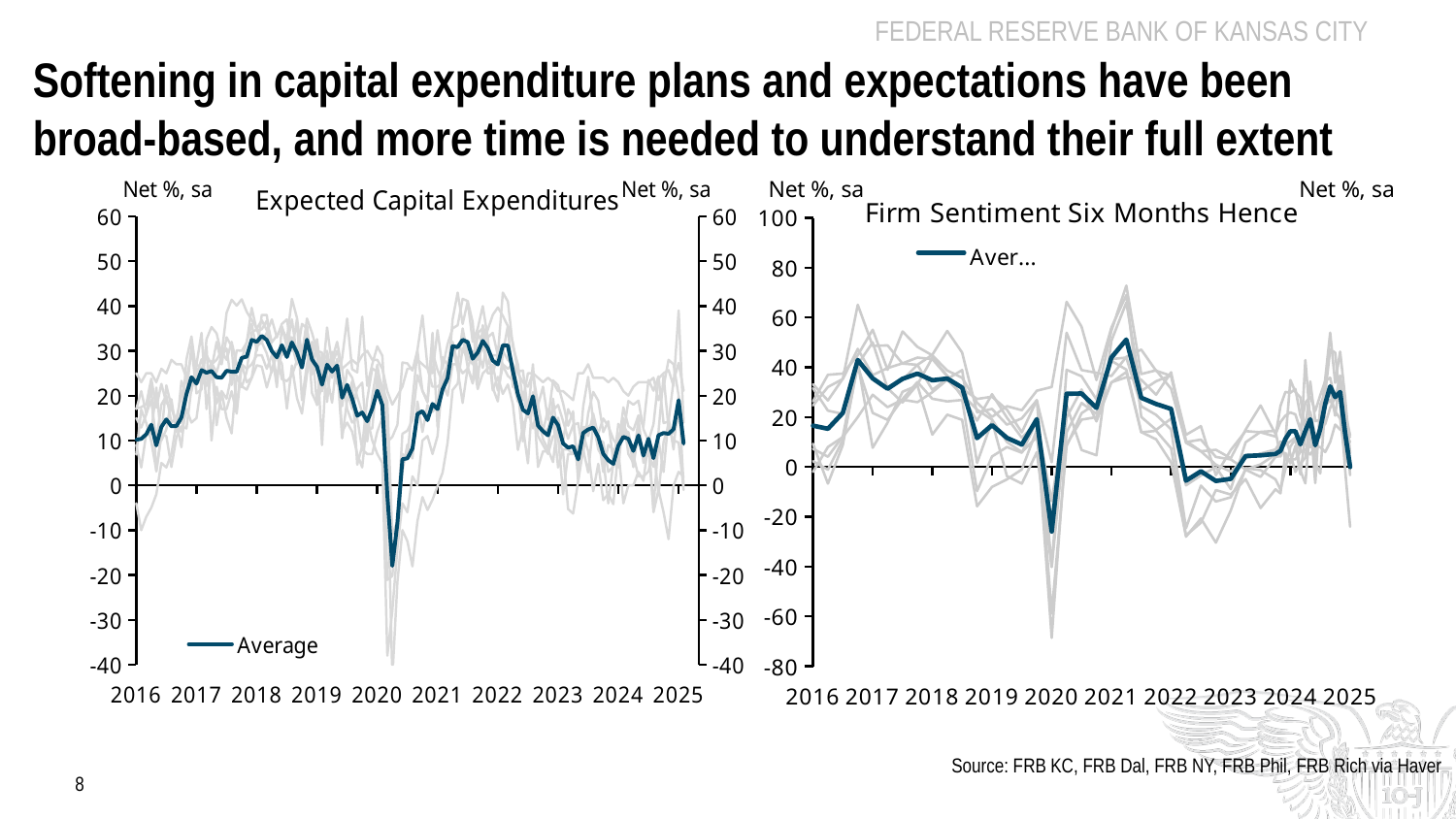
In the 'Expected Capital Expenditures' chart, what label does the legend give to the dark blue line? Average In the 'Expected Capital Expenditures' chart, is the lowest value of the Average line in 2020 greater or less than -10? less What kind of chart is the 'Expected Capital Expenditures' chart on the left? line chart In the 'Expected Capital Expenditures' chart, is the peak of the Average line in 2021 greater or less than 20? greater In the 'Firm Sentiment Six Months Hence' chart, which is larger for the average line: the 2021 peak or the 2020 trough? the 2021 peak In the 'Firm Sentiment Six Months Hence' chart, is the lowest value of the average line in 2020 greater or less than 0? less In the 'Expected Capital Expenditures' chart, how many years are labeled on the x axis? 10 In the 'Firm Sentiment Six Months Hence' chart, in which year does the average line reach its highest point? 2021 What is the title of the chart on the right side of the slide? Firm Sentiment Six Months Hence In the 'Expected Capital Expenditures' chart, in which year does the Average line reach its lowest point? 2020 In the 'Expected Capital Expenditures' chart, does the Average line rise or fall from its 2021 peak to 2024? fall